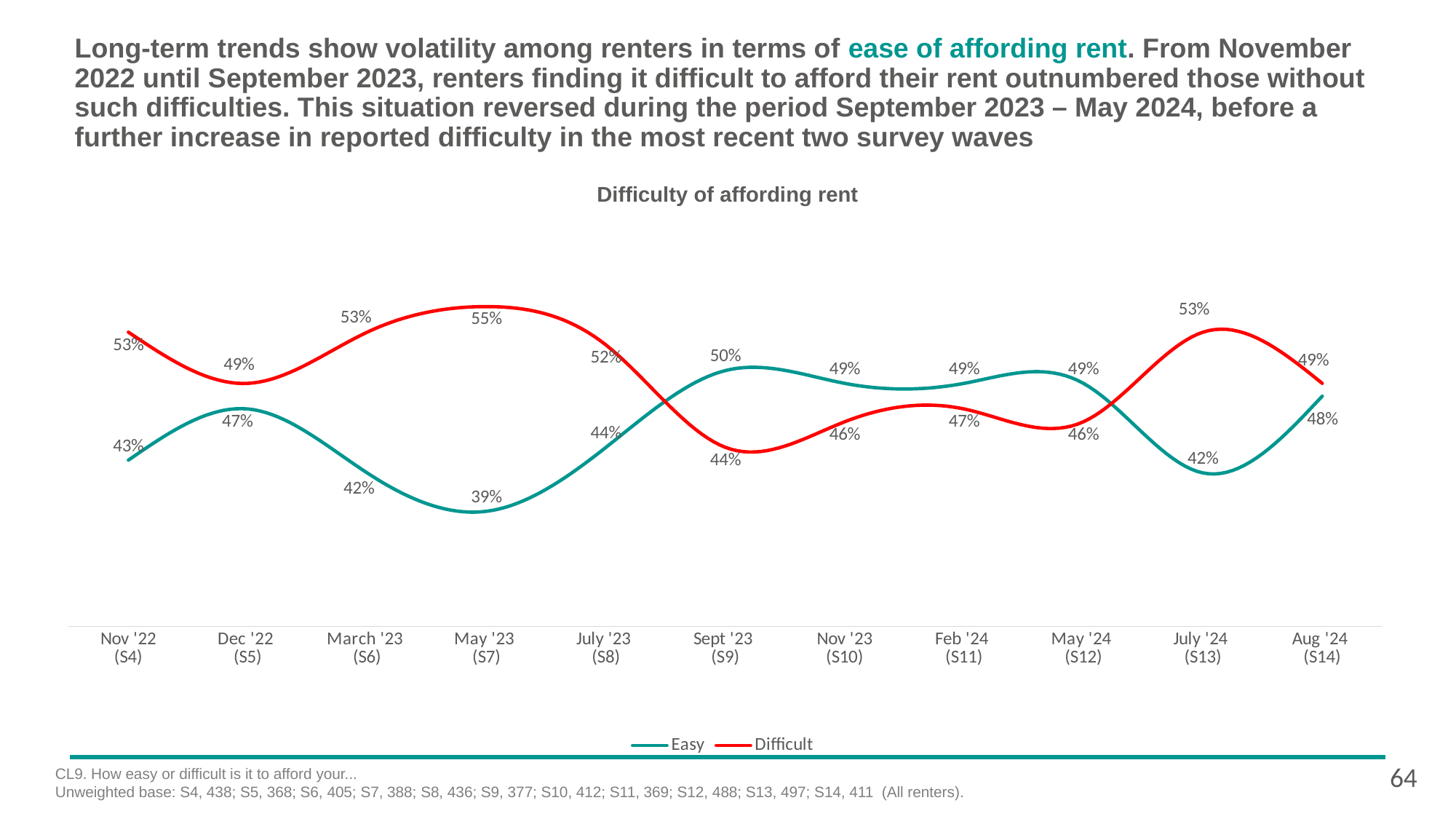
What is the difference between the Difficult and Easy values at May '23 (S7)? 16 percentage points How many survey waves are plotted on the x axis? 11 At Sept '23 (S9), which series has the larger value, Easy or Difficult? Easy Does the Easy series rise or fall between May '24 (S12) and July '24 (S13)? Fall How many series does the legend list? 2 At which survey wave does the Difficult series reach its highest value? May '23 (S7) What kind of chart is shown on the slide? Line chart What is the value of the Difficult series at May '23 (S7)? 55% At which survey wave does the Easy series reach its lowest value? May '23 (S7) What is the value of the Easy series at Aug '24 (S14)? 48% At July '24 (S13), which series has the larger value, Easy or Difficult? Difficult What is the value of the Easy series at Sept '23 (S9)? 50%